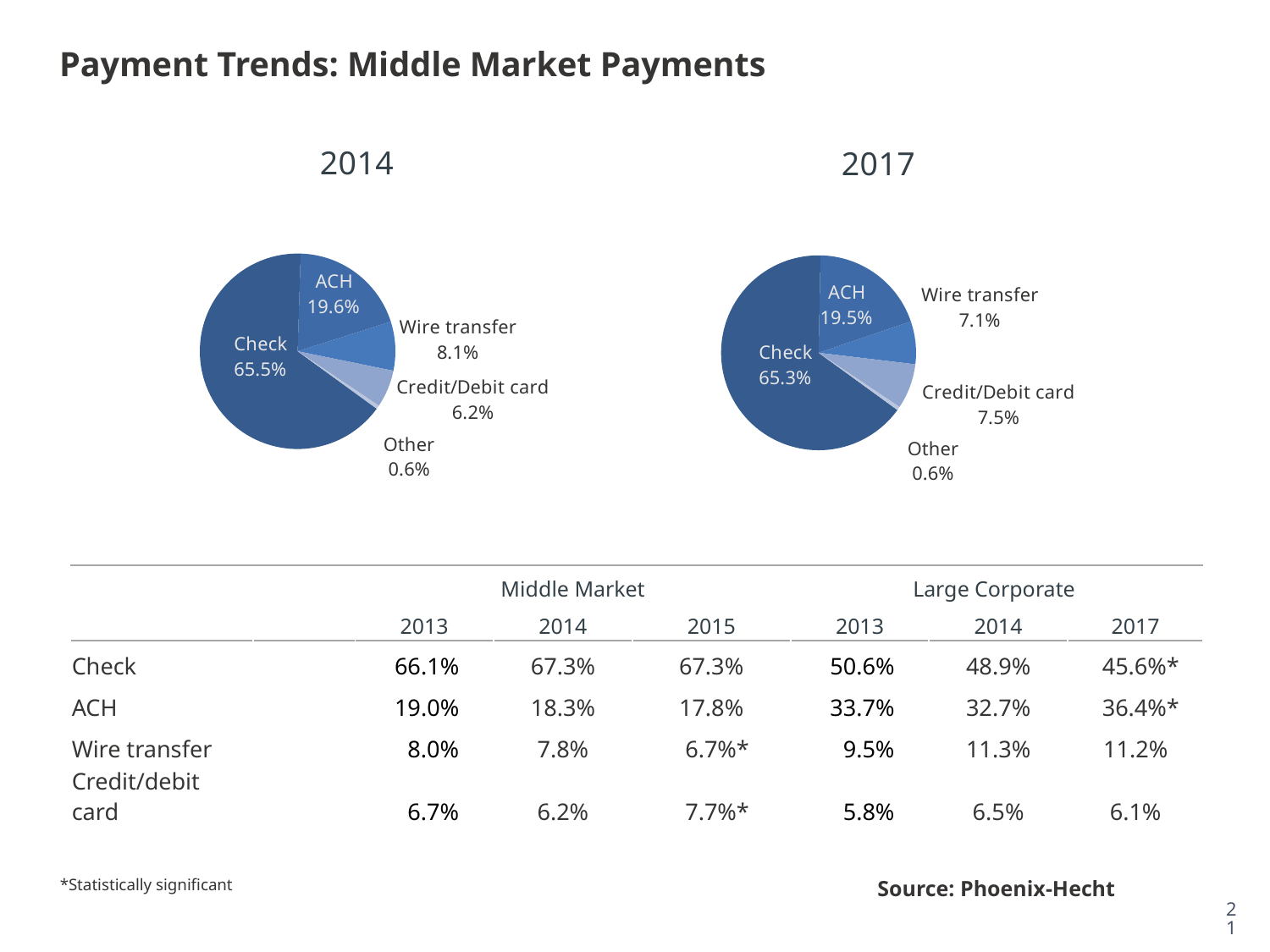
What type of chart is used to show the 2014 payment mix? Pie chart How many categories are shown in the 2017 pie chart? 5 In the 2017 pie chart, which category has the smallest slice? Other What is the difference between the Check share in the 2014 pie chart and the Check share in the 2017 pie chart? 0.2% In the 2014 pie chart, what share does Check have? 65.5% In the 2017 pie chart, which is larger: Credit/Debit card or Wire transfer? Credit/Debit card What is the title of the slide containing the two pie charts? Payment Trends: Middle Market Payments In the 2017 pie chart, what share does Credit/Debit card have? 7.5% In the 2014 pie chart, which is larger: Wire transfer or Credit/Debit card? Wire transfer In the 2017 pie chart, what is the value for Wire transfer? 7.1% In the 2014 pie chart, which category has the largest slice? Check In the 2014 pie chart, what is the difference between the ACH share and the Wire transfer share? 11.5%